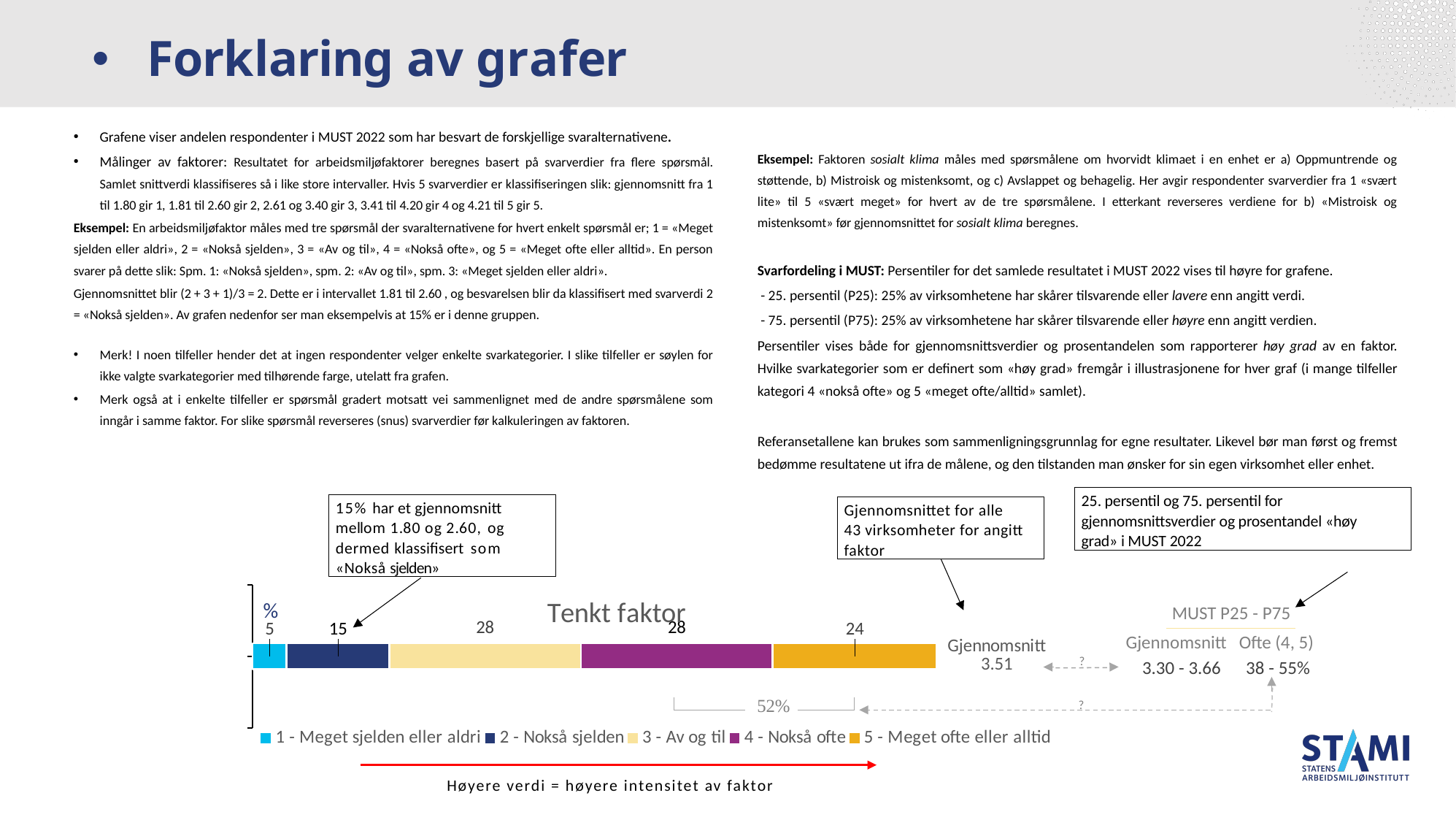
What is the title of the chart on the slide? Tenkt faktor What is the combined value of "4 - Nokså ofte" and "5 - Meget ofte eller alltid" as shown below the bar? 52% How many entries does the chart legend list? 5 What is the Gjennomsnitt (average) value shown to the right of the bar? 3.51 Which is larger: the value for "4 - Nokså ofte" or the value for "5 - Meget ofte eller alltid"? 4 - Nokså ofte What is the MUST P25 - P75 range shown for Gjennomsnitt? 3.30 - 3.66 What is the value for "2 - Nokså sjelden" in the chart? 15 Which legend category has the lowest value in the chart? 1 - Meget sjelden eller aldri What kind of chart is shown on the slide? Stacked bar chart What is the value for "5 - Meget ofte eller alltid" in the chart? 24 What is the value for "1 - Meget sjelden eller aldri" in the chart? 5 What is the difference between the values for "3 - Av og til" and "2 - Nokså sjelden"? 13